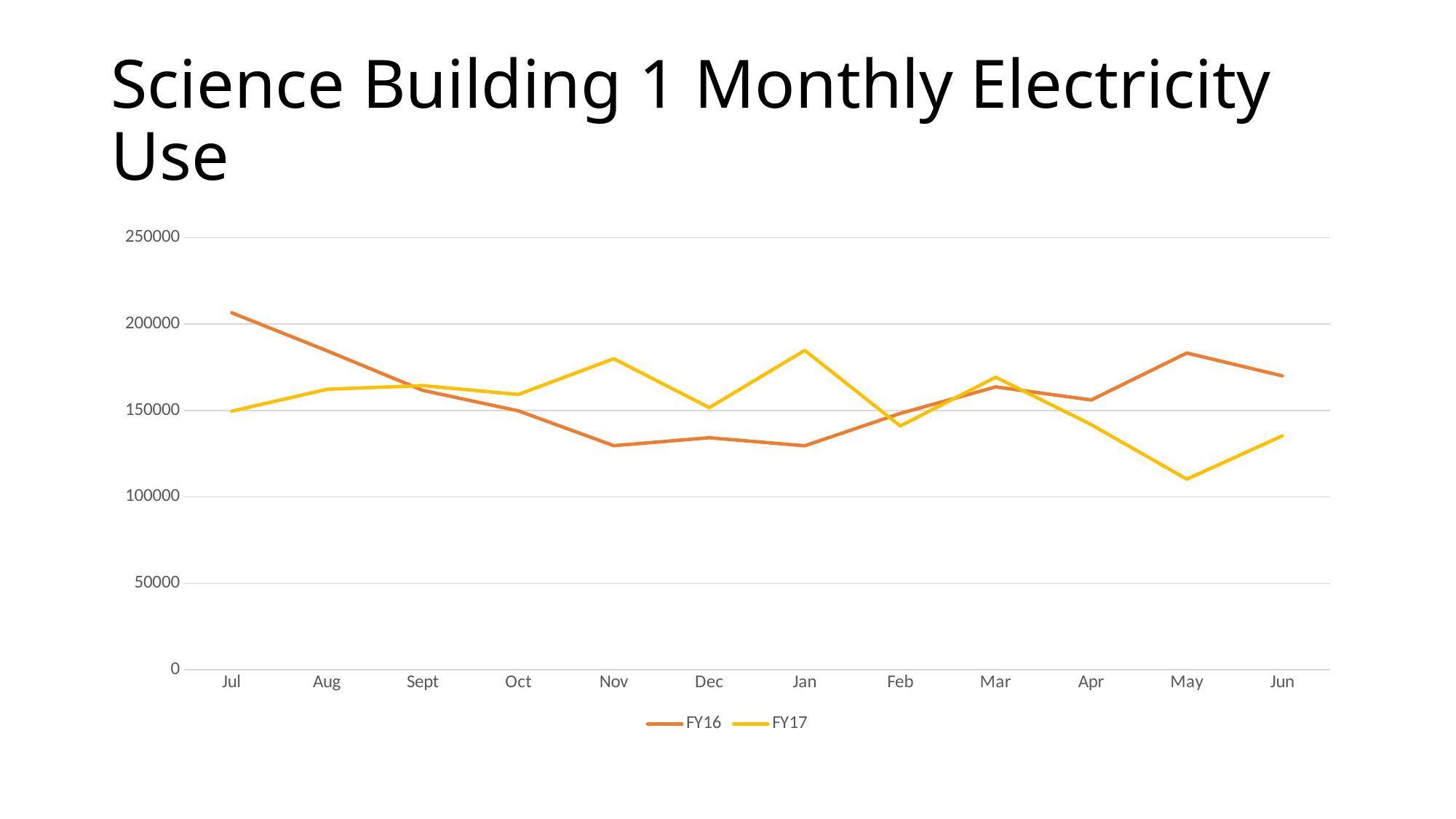
In which month is the FY17 value lowest? May Is the FY16 value for Jul greater or less than 200000? greater What type of chart is shown on the slide? line chart Does the FY16 line rise or fall from Jul to Nov? fall Which series has the larger value in Nov, FY16 or FY17? FY17 How many months are plotted along the x axis? 12 Is the FY16 value for Nov greater or less than 150000? less Is the FY17 value for May greater or less than 150000? less How many series does the legend list? 2 Which series has the larger value in Jul, FY16 or FY17? FY16 What is the title of the chart on the slide? Science Building 1 Monthly Electricity Use In which month is the FY16 value highest? Jul